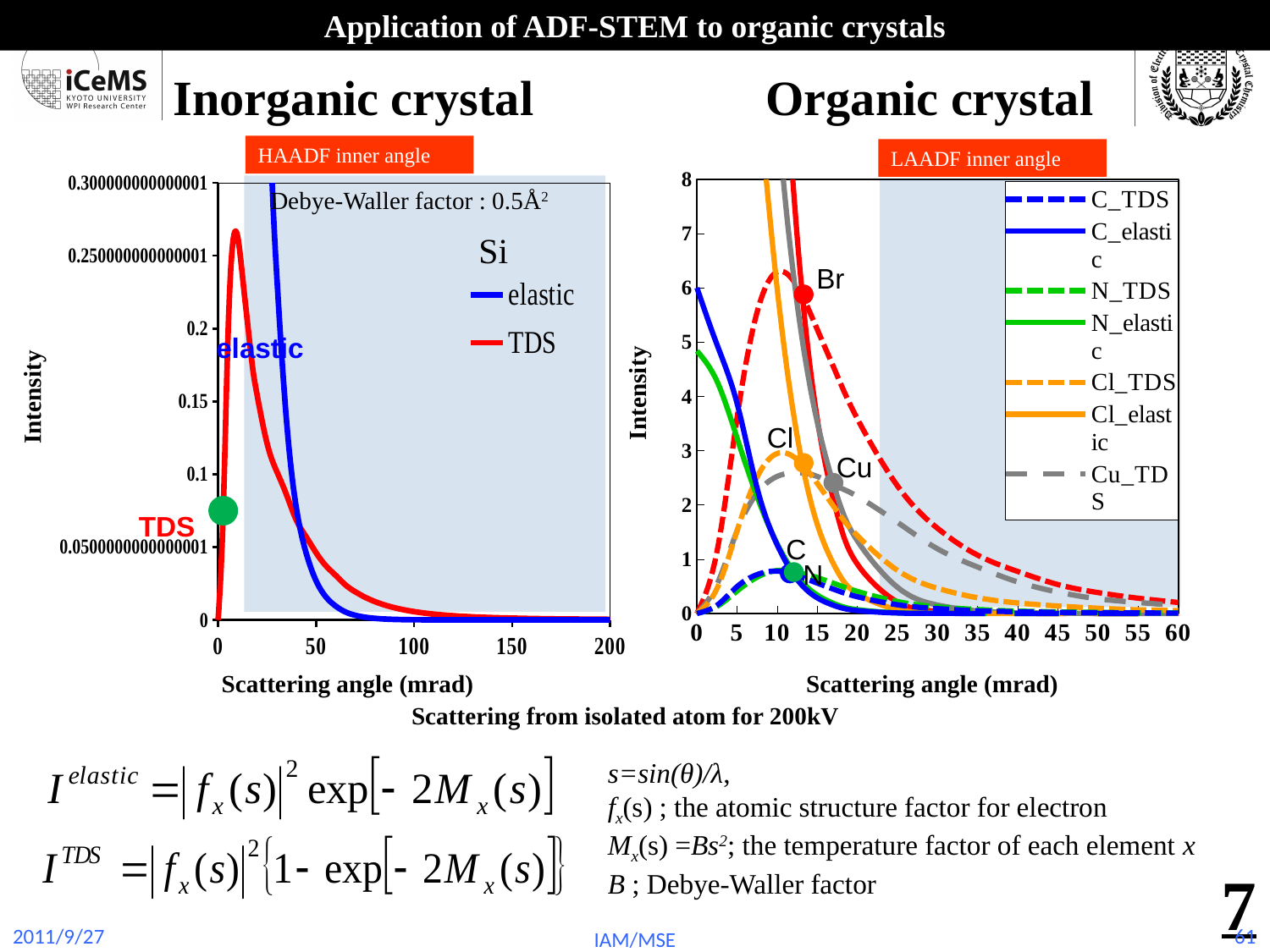
What kind of chart is the Organic crystal chart on the right? line chart In the Organic crystal chart, at 0 mrad, which is larger: C_elastic or N_elastic? C_elastic In the Inorganic crystal chart, is the peak value of the TDS curve greater or less than 0.2? greater In the Inorganic crystal chart, does the elastic curve rise or fall as the scattering angle increases from 25 to 100 mrad? fall What kind of chart is the Inorganic crystal chart on the left? line chart In the Organic crystal chart, is the N_elastic value at 0 mrad greater or less than 5? less In the Inorganic crystal chart, what is the label of the x axis? Scattering angle (mrad) In the Inorganic crystal chart, is the TDS value at 100 mrad greater or less than 0.05? less How many series does the legend of the Inorganic crystal chart list? 2 In the Organic crystal chart, which element's TDS curve is drawn as a grey dashed line? Cu How many series does the legend of the Organic crystal chart list? 7